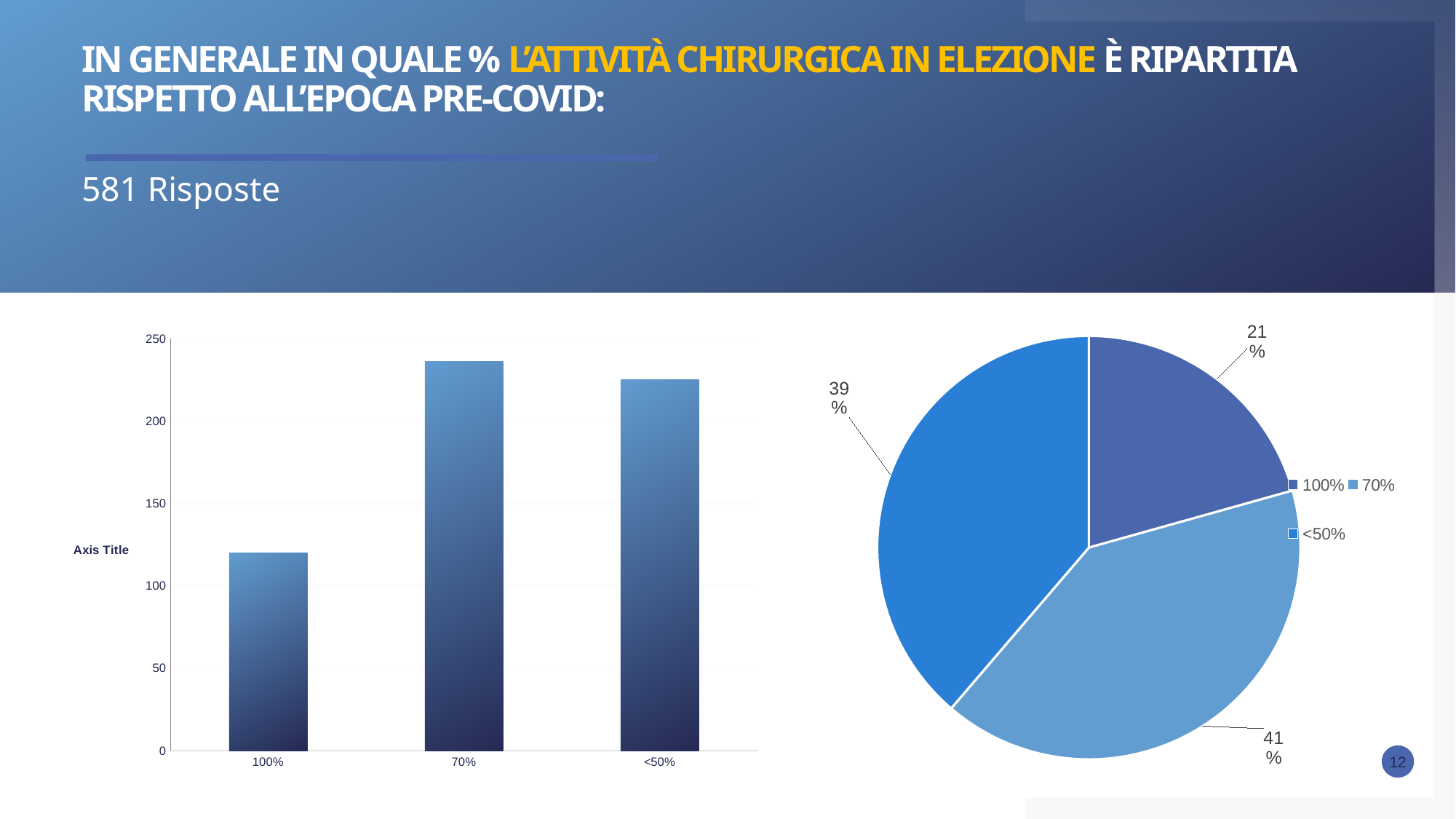
In the bar chart on the left, is the value for 70% greater or less than 200? greater In the bar chart on the left, how many categories are shown on the x axis? 3 In the bar chart on the left, which is larger, the value for 100% or the value for <50%? <50% In the bar chart on the left, is the value for 100% greater or less than 150? less What kind of chart is the chart on the right of the slide? pie chart In the bar chart on the left, which category has the lowest bar? 100% In the pie chart on the right, what share is shown for the 70% slice? 41% In the pie chart on the right, what share is shown for the 100% slice? 21% In the pie chart on the right, which slice is the smallest? 100% In the bar chart on the left, is the value for <50% greater or less than 200? greater What kind of chart is the chart on the left of the slide? bar chart In the pie chart on the right, how many entries does the legend list? 3